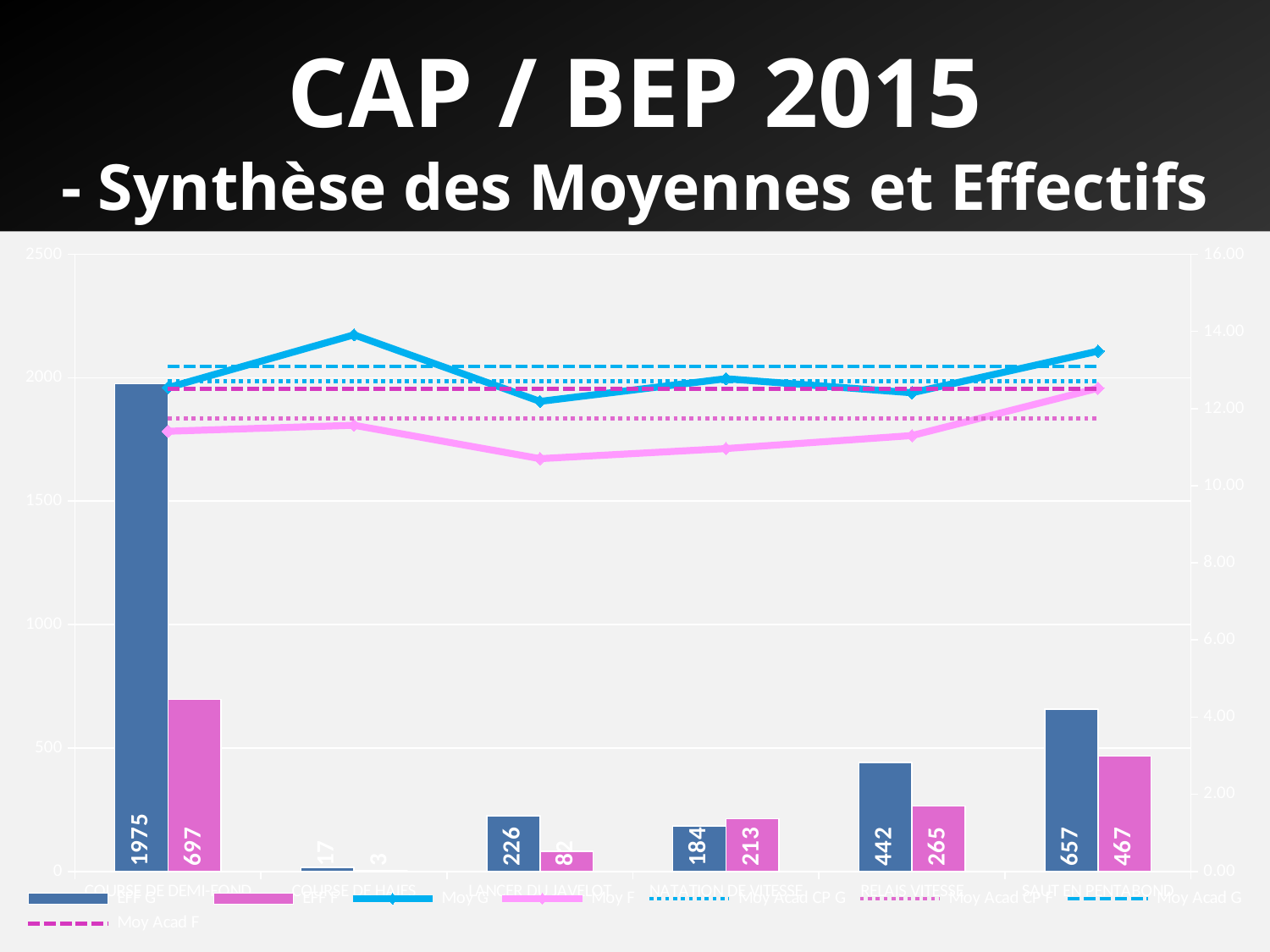
Which category has the highest Eff G value? Course de demi-fond How many series does the legend list? 8 Which category has the lowest Eff F value? Course de haies What is the Eff F value for Saut en pentabond? 467 Which is larger for Natation de vitesse, Eff G or Eff F? Eff F What is the Eff F value for Natation de vitesse? 213 Is the Eff G value for Saut en pentabond greater or less than 500? greater What is the Eff G value for Course de demi-fond? 1975 What is the total of Eff G and Eff F for Lancer du javelot? 308 What is the difference between the Eff G and Eff F values for Relais vitesse? 177 How many categories are shown on the x axis? 6 Which series is drawn as a solid pink line? Moy F